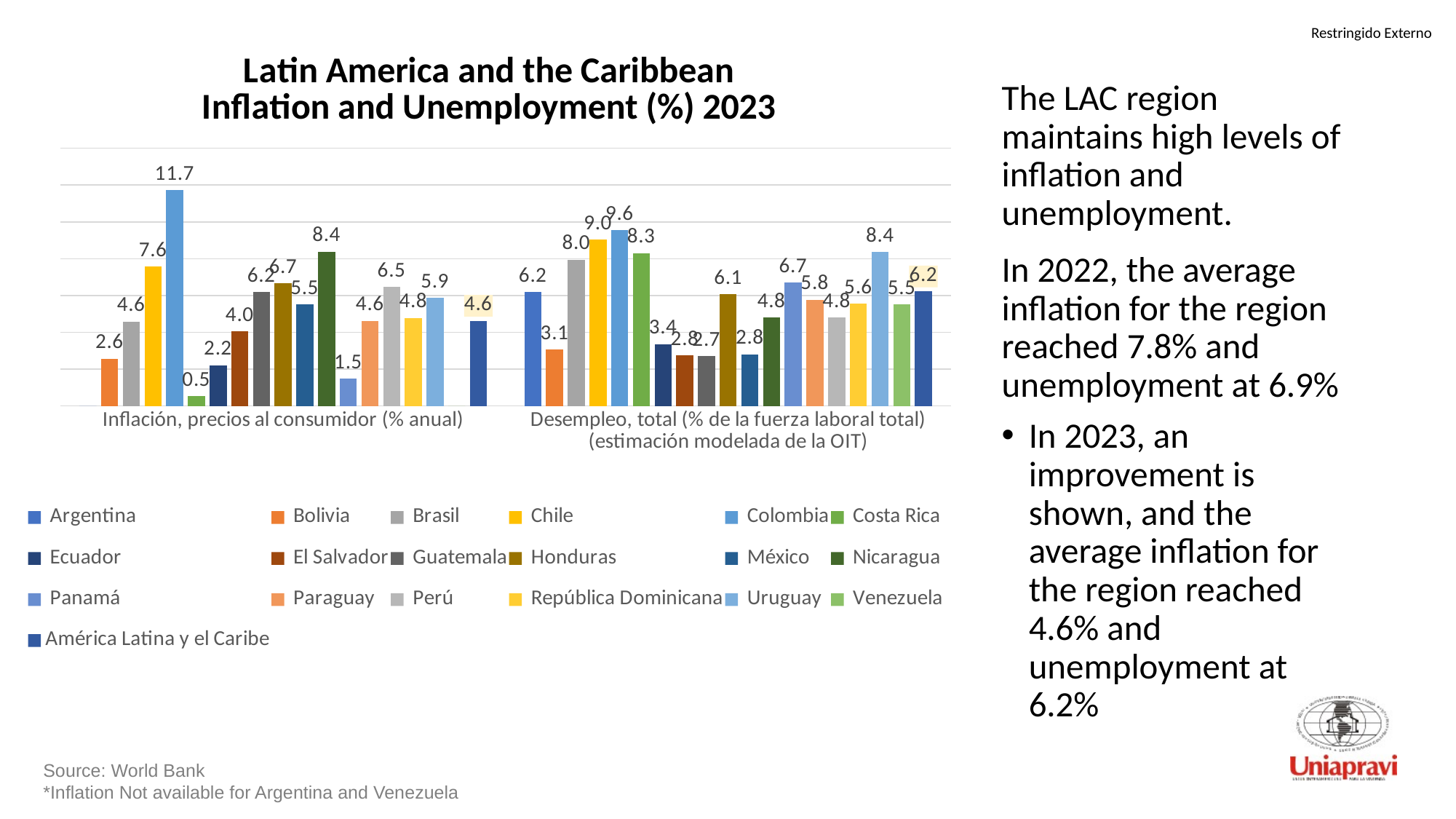
Which has a higher unemployment value, Chile or Brasil? Chile What is the inflation value (Inflación, precios al consumidor) for Colombia? 11.7 What is the difference between Colombia's inflation value and Chile's inflation value? 4.1 Which country has the highest unemployment value in the chart? Colombia Which country has the lowest inflation value in the chart? Costa Rica What is the title of the chart? Latin America and the Caribbean Inflation and Unemployment (%) 2023 Which country has the highest inflation value in the chart? Colombia What is the unemployment value for América Latina y el Caribe? 6.2 How many series does the legend list? 19 What is the unemployment value (Desempleo, total) for Uruguay? 8.4 What kind of chart is shown on the slide? Bar chart Which country has the lowest unemployment value in the chart? Guatemala